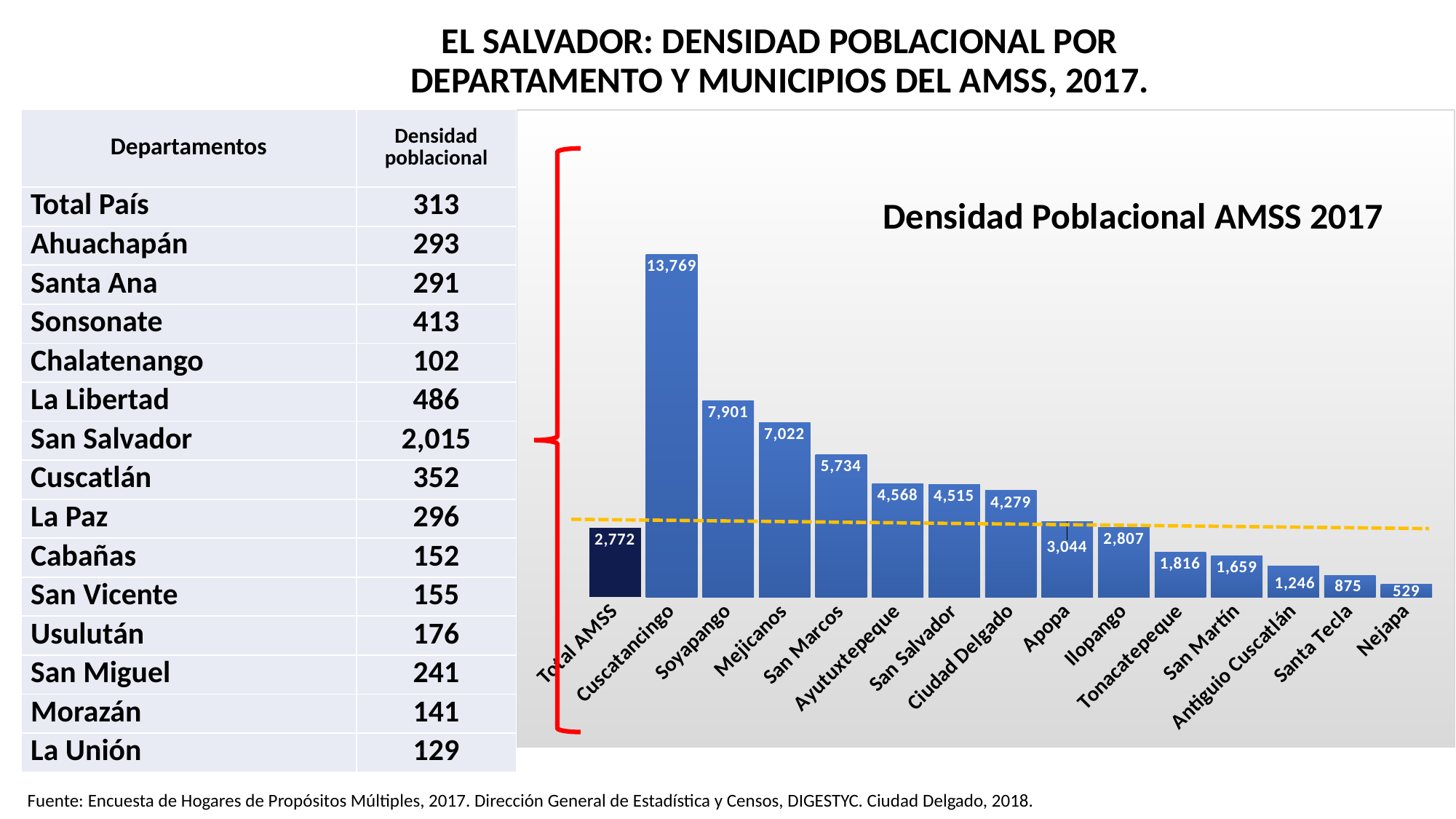
What is the difference between the values for Soyapango and Mejicanos? 879 What is the difference between the values for Cuscatancingo and Nejapa? 13,240 What is the population density value shown for Cuscatancingo in the chart? 13,769 What is the value labelled on the Total AMSS bar? 2,772 What is the title of the chart? Densidad Poblacional AMSS 2017 Which has a larger value, Apopa or Ilopango? Apopa What value is shown for Santa Tecla? 875 Which municipality has the lowest population density in the chart? Nejapa How many bars are plotted in the chart? 15 Which municipality has the highest population density in the chart? Cuscatancingo What type of chart is shown on the slide? Bar chart What value does the chart show for Soyapango? 7,901